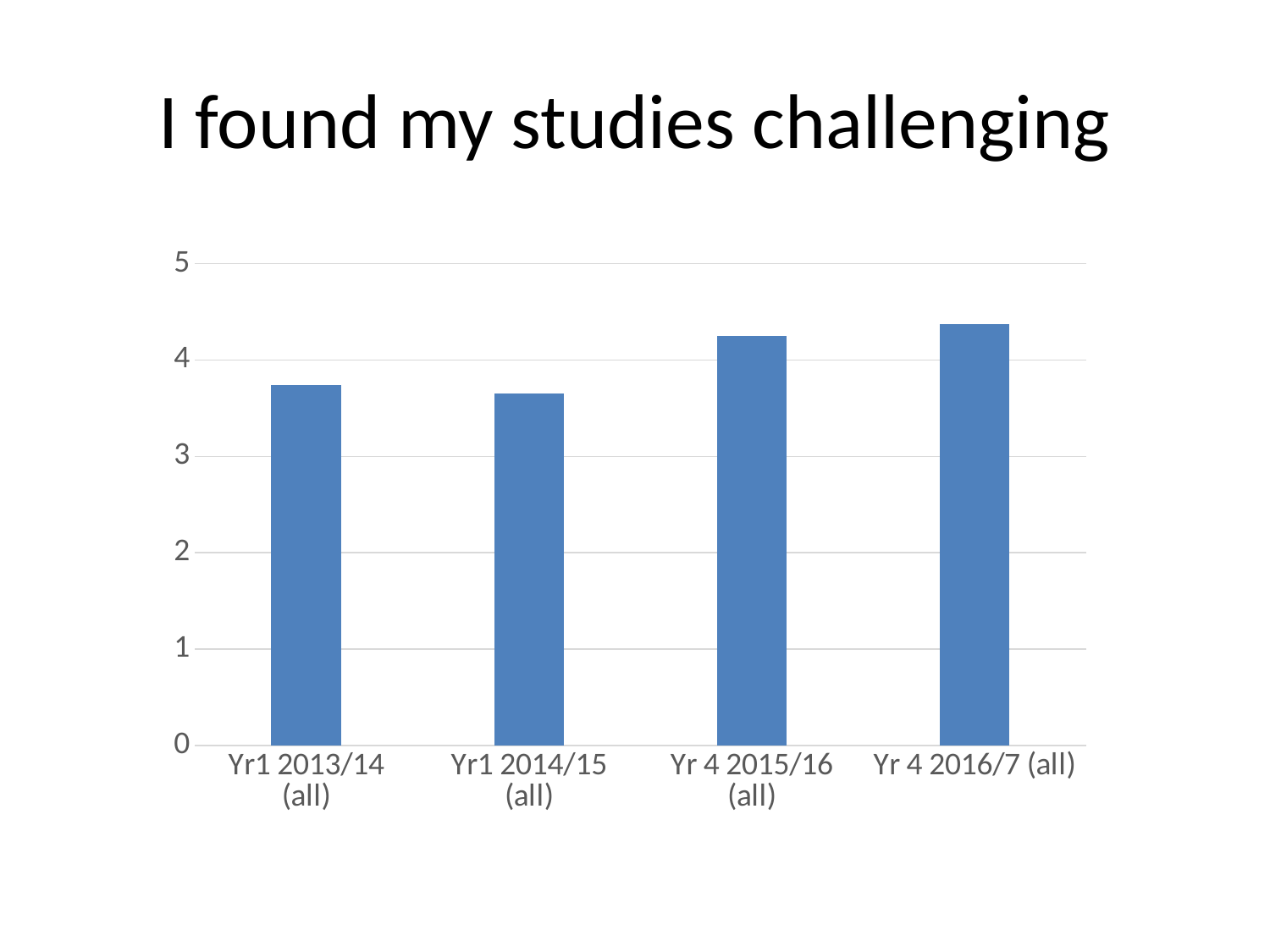
Is the value for Yr 4 2015/16 (all) greater or less than 4? greater Is the value for Yr1 2013/14 (all) greater or less than 4? less What is the highest value shown on the vertical axis? 5 Which is larger, the value for Yr1 2014/15 (all) or the value for Yr 4 2016/7 (all)? Yr 4 2016/7 (all) Is the value for Yr1 2014/15 (all) greater or less than 3? greater What is the title of the chart? I found my studies challenging Which category has the highest value? Yr 4 2016/7 (all) How many categories are plotted on the chart? 4 What kind of chart is shown on the slide? bar chart Which category has the lowest value? Yr1 2014/15 (all) Which is larger, the value for Yr1 2013/14 (all) or the value for Yr 4 2015/16 (all)? Yr 4 2015/16 (all)